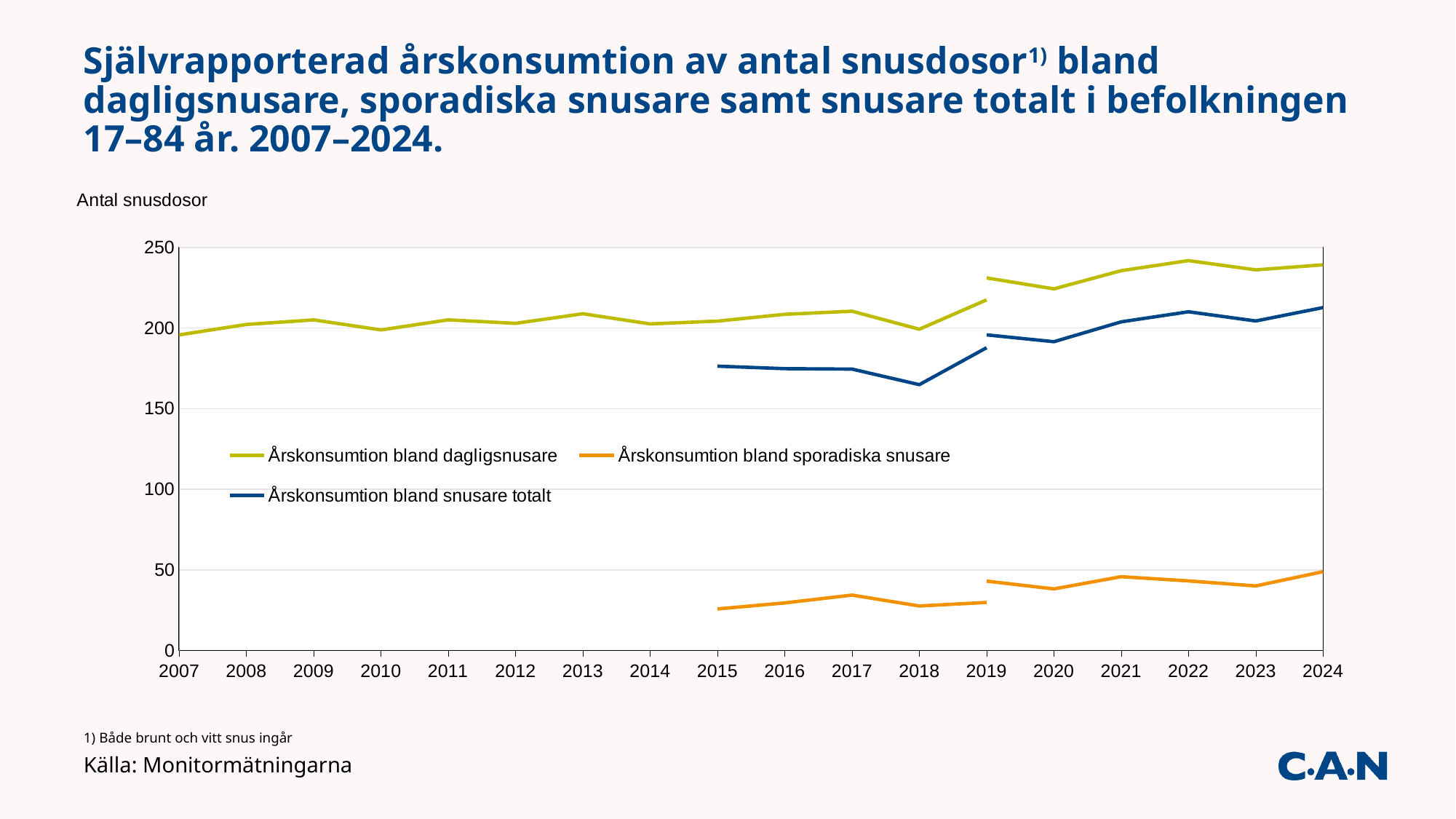
In 2020, which is larger: Årskonsumtion bland dagligsnusare or Årskonsumtion bland sporadiska snusare? Årskonsumtion bland dagligsnusare Is the value for Årskonsumtion bland sporadiska snusare in 2015 greater or less than 50? less Which series has the highest value in 2024? Årskonsumtion bland dagligsnusare How many series does the legend list? 3 Is the value for Årskonsumtion bland snusare totalt in 2024 greater or less than 200? greater Is the value for Årskonsumtion bland dagligsnusare in 2022 greater or less than 200? greater How many years are shown on the x axis? 18 What kind of chart is shown on the slide? line chart Does Årskonsumtion bland sporadiska snusare rise or fall overall from 2015 to 2024? rise What is the label on the y axis of the chart? Antal snusdosor In which year is Årskonsumtion bland snusare totalt at its lowest? 2018